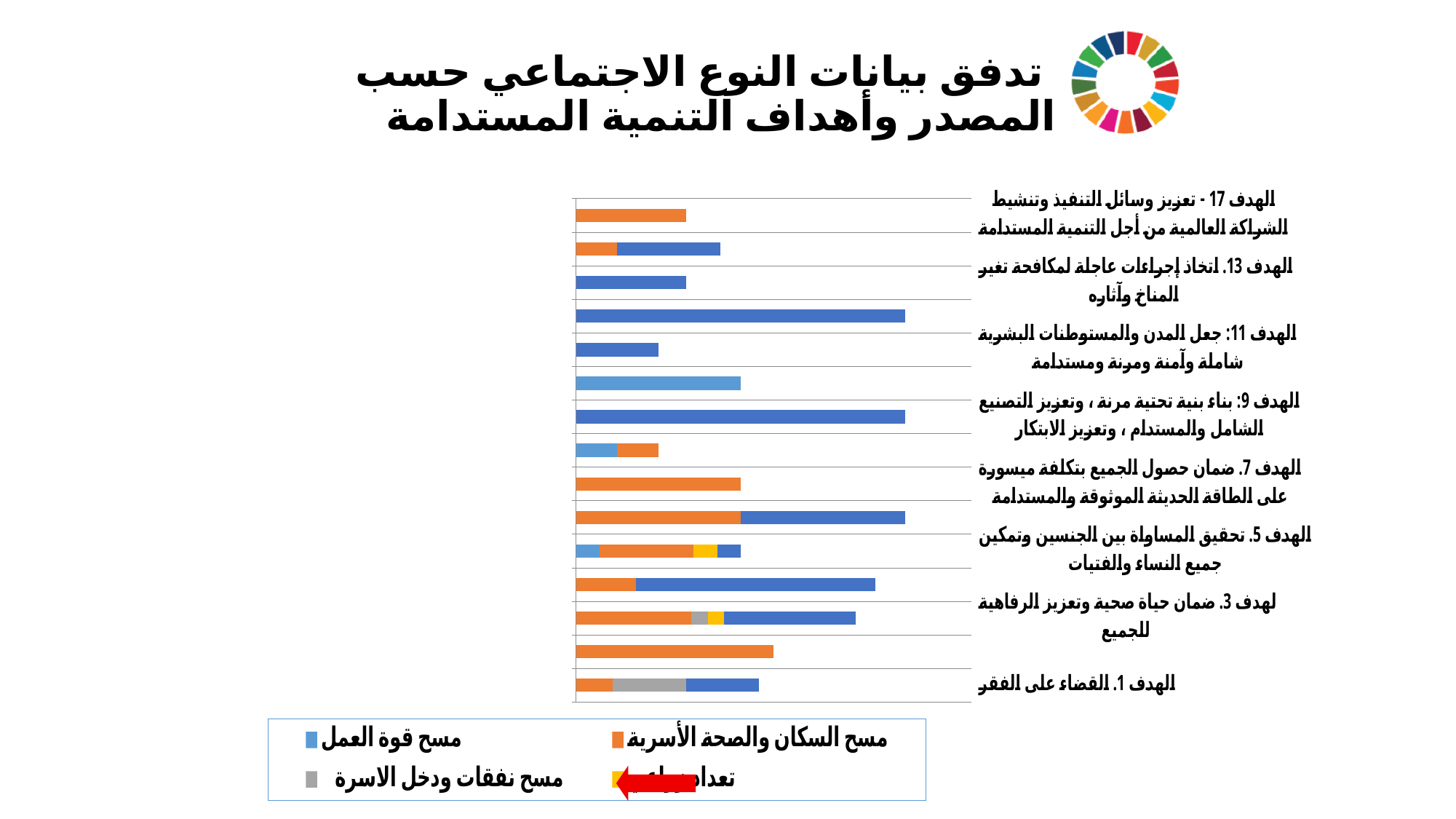
Which bar is longer, the one for الهدف 9 or the one for الهدف 17? الهدف 9 Which series is shown in gray in the legend? مسح نفقات ودخل الاسرة How many bars are plotted in the chart? 15 How many series does the legend list? 4 Which series is shown in blue in the legend? مسح قوة العمل Which bar is longer, the one for الهدف 9 or the one for الهدف 13? الهدف 9 What kind of chart is shown on the slide? bar chart Which bar is longer, the one for الهدف 3 or the one for الهدف 11? الهدف 3 How many goal labels are shown on the category axis? 8